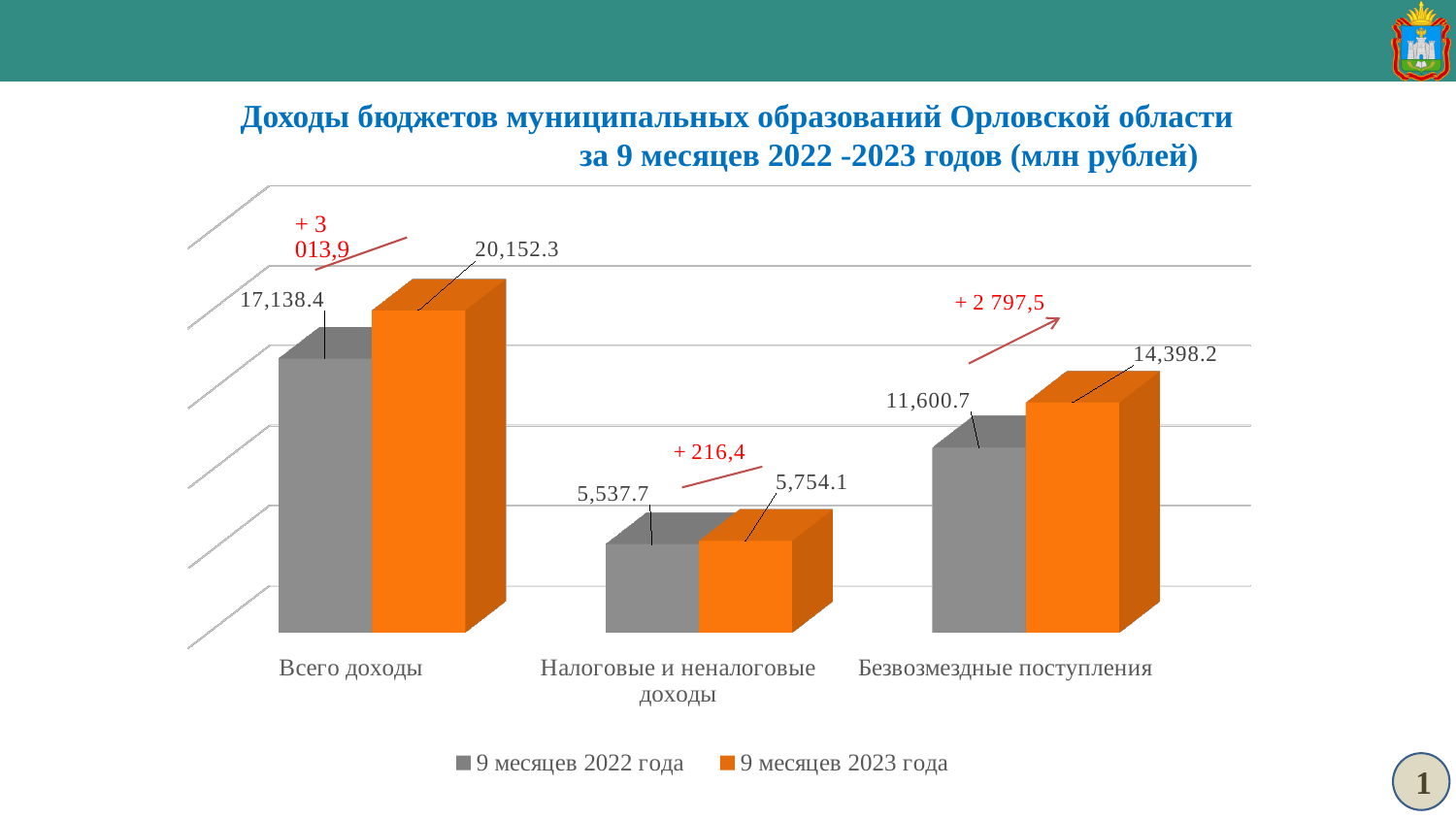
What is the value for Безвозмездные поступления in the 9 месяцев 2023 года series? 14,398.2 What is the value for Налоговые и неналоговые доходы in the 9 месяцев 2022 года series? 5,537.7 What is the value for Всего доходы in the 9 месяцев 2023 года series? 20,152.3 Which category has the highest value in the 9 месяцев 2022 года series? Всего доходы Which is larger for Налоговые и неналоговые доходы: the 9 месяцев 2022 года value or the 9 месяцев 2023 года value? 9 месяцев 2023 года What is the difference between the 9 месяцев 2023 года and 9 месяцев 2022 года values for Всего доходы? 3,013.9 How many series does the legend list? 2 How many categories are shown on the x axis? 3 Which category has the lowest value in the 9 месяцев 2023 года series? Налоговые и неналоговые доходы What is the difference between the 9 месяцев 2023 года and 9 месяцев 2022 года values for Безвозмездные поступления? 2,797.5 What kind of chart is shown on the slide? Bar chart What is the value for Безвозмездные поступления in the 9 месяцев 2022 года series? 11,600.7